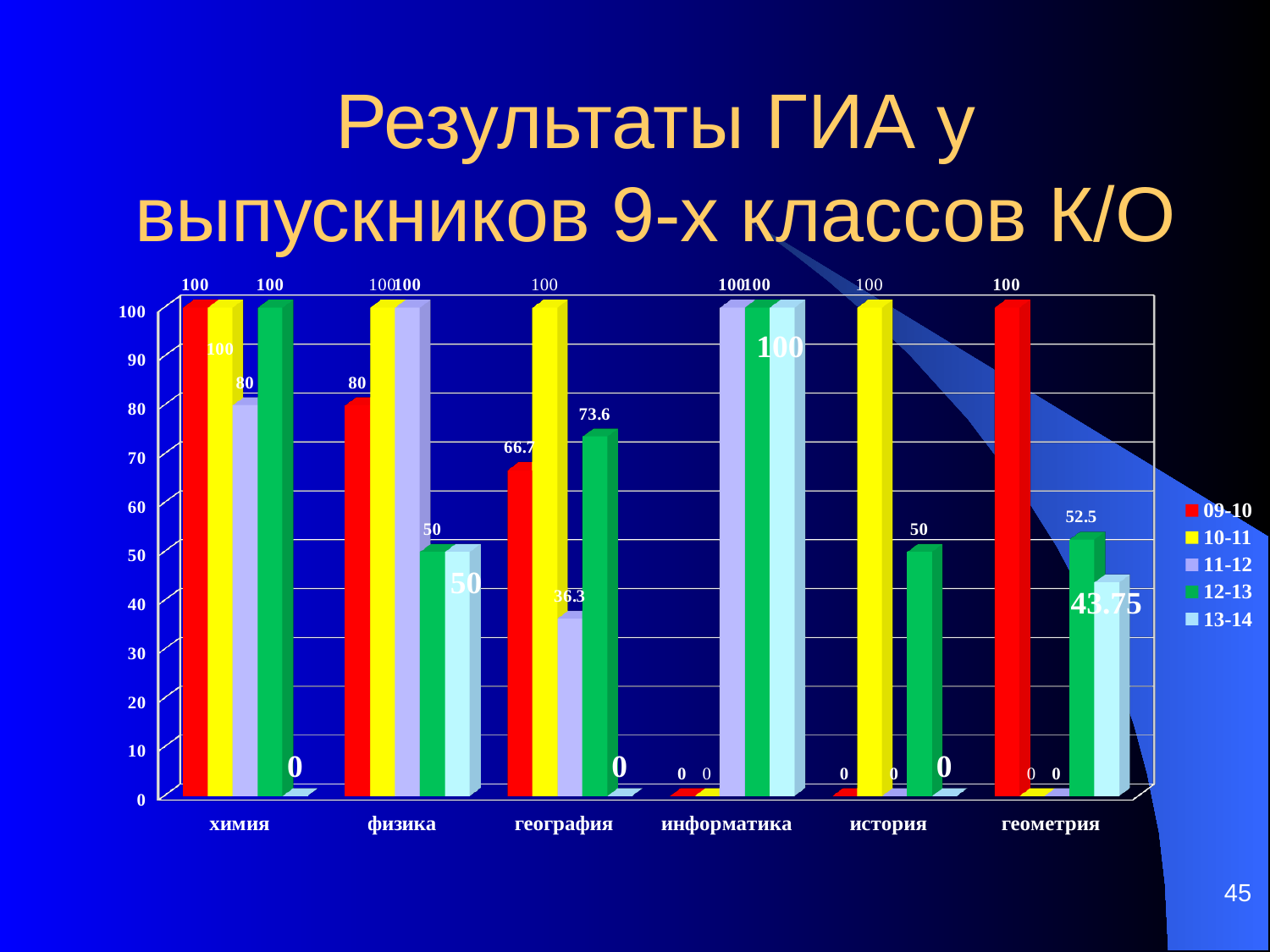
In география, which series has the lowest value? 13-14 How many subject categories are shown on the x axis? 6 What is the value for 09-10 in физика? 80 What is the value for 13-14 in геометрия? 43.75 What is the value for 11-12 in география? 36.3 What is the difference between the 09-10 and 12-13 values for физика? 30 What is the difference between the 12-13 and 11-12 values for география? 37.3 How many series does the legend list? 5 What kind of chart is shown on the slide? bar chart In география, which series has the highest value? 10-11 What is the value for 12-13 in география? 73.6 In геометрия, which is larger: the 12-13 value or the 13-14 value? 12-13